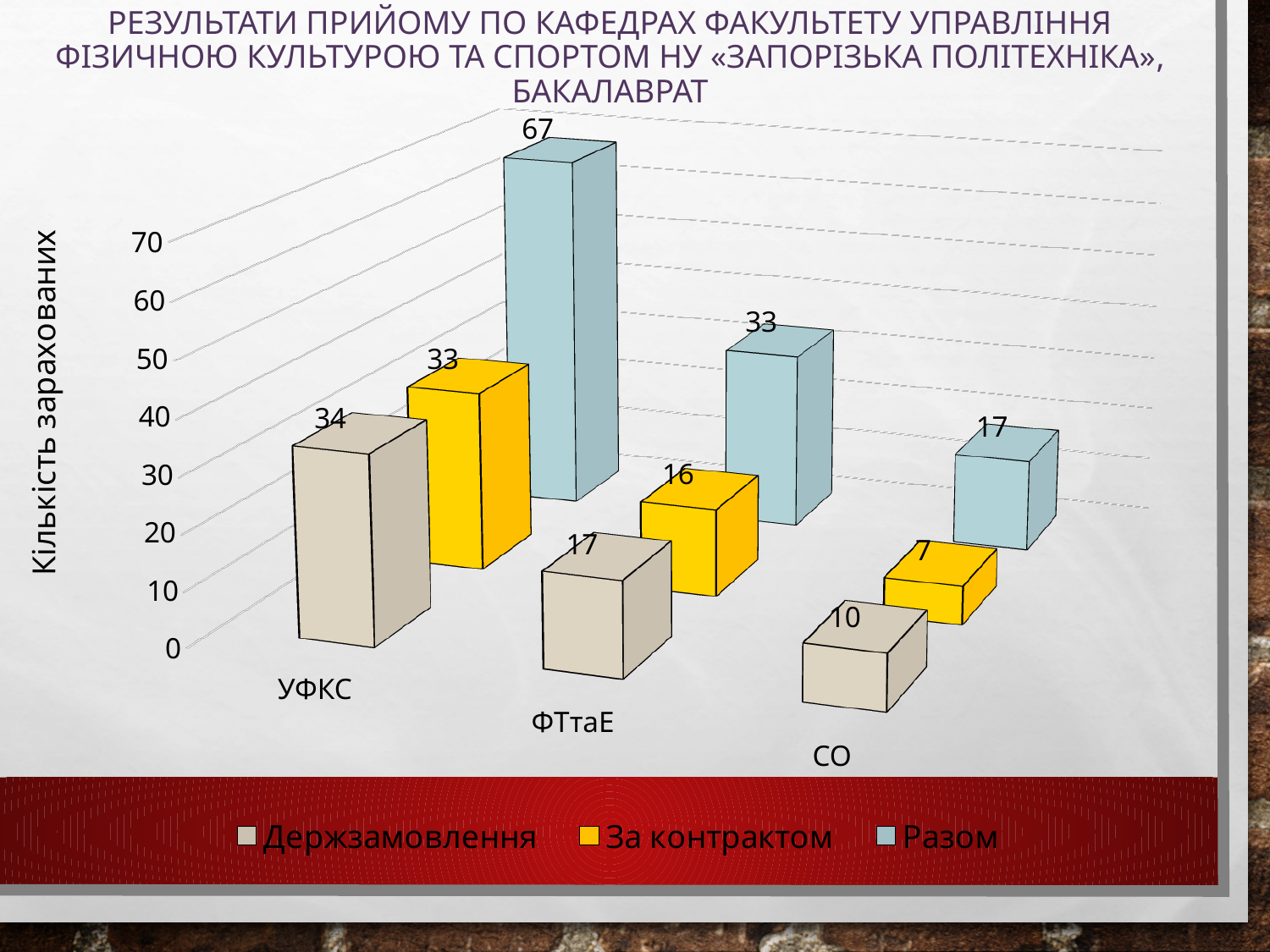
What is the value of Держзамовлення for УФКС? 34 What is the value of За контрактом for СО? 7 What is the difference between the Разом values for УФКС and ФТтаЕ? 34 What is the label of the vertical axis? Кількість зарахованих What is the value of За контрактом for ФТтаЕ? 16 Which category has the highest Разом value? УФКС How many categories are shown on the x axis? 3 How many series does the legend list? 3 What is the value of Разом for СО? 17 What kind of chart is shown on the slide? bar chart Which category has the lowest Держзамовлення value? СО Which is larger: Держзамовлення for ФТтаЕ or За контрактом for ФТтаЕ? Держзамовлення for ФТтаЕ